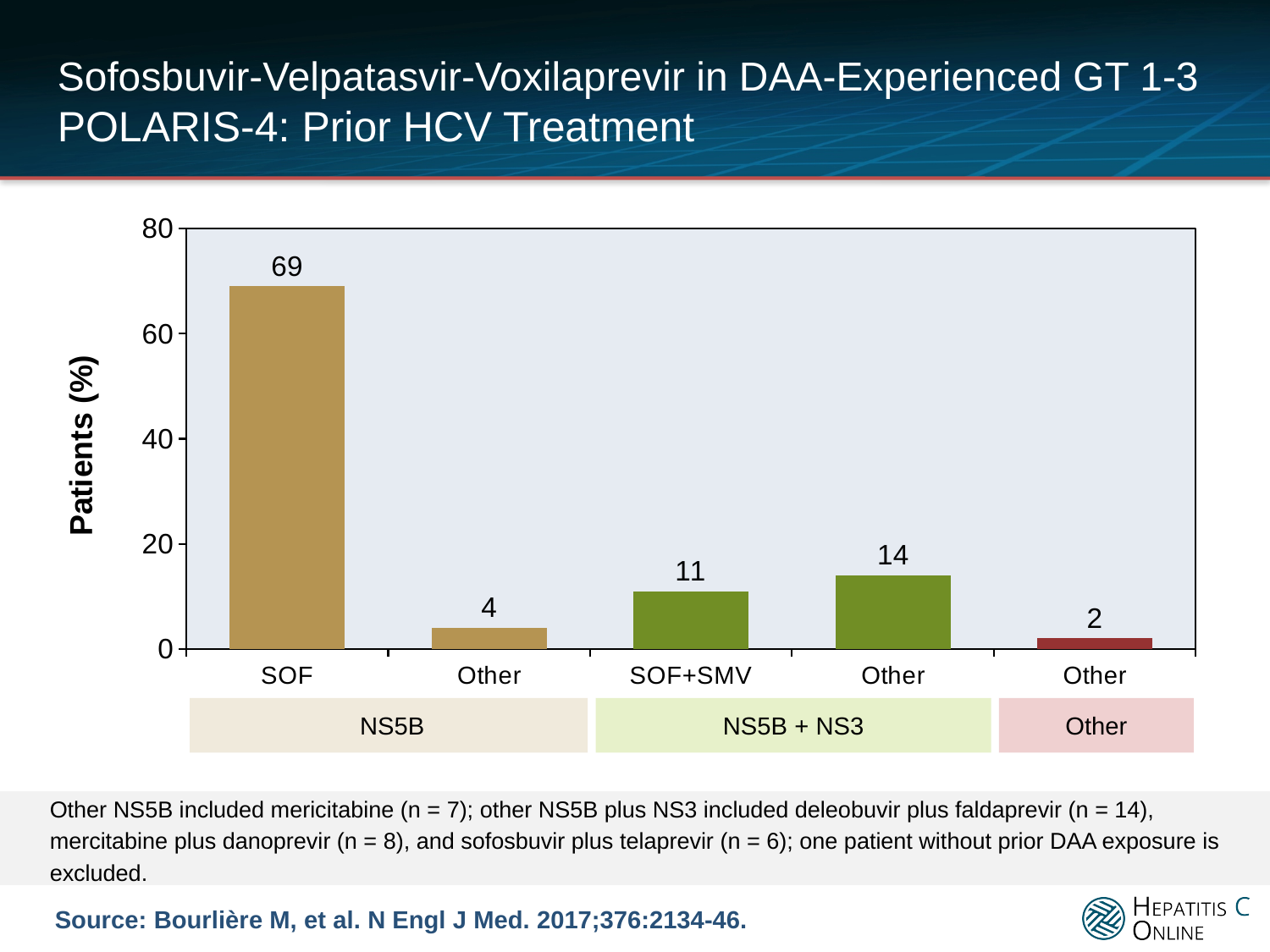
How many bars are plotted on the chart? 5 What percentage of patients had prior 'Other' treatment in the NS5B + NS3 group? 14 Which prior treatment category has the highest percentage of patients? SOF What is the label of the y-axis? Patients (%) What is the difference between the SOF bar and the SOF+SMV bar? 58 What type of chart is shown on the slide? Bar chart What percentage of patients had prior SOF treatment in the NS5B group? 69 What percentage of patients fall in the 'Other' category outside the NS5B and NS5B + NS3 groups? 2 Is the value for SOF greater or less than 60? greater Which bar has the lowest value on the chart? Other (2) Which is larger: the 'Other' bar in the NS5B group or the 'Other' bar in the NS5B + NS3 group? Other in NS5B + NS3 What percentage of patients had prior SOF+SMV treatment in the NS5B + NS3 group? 11